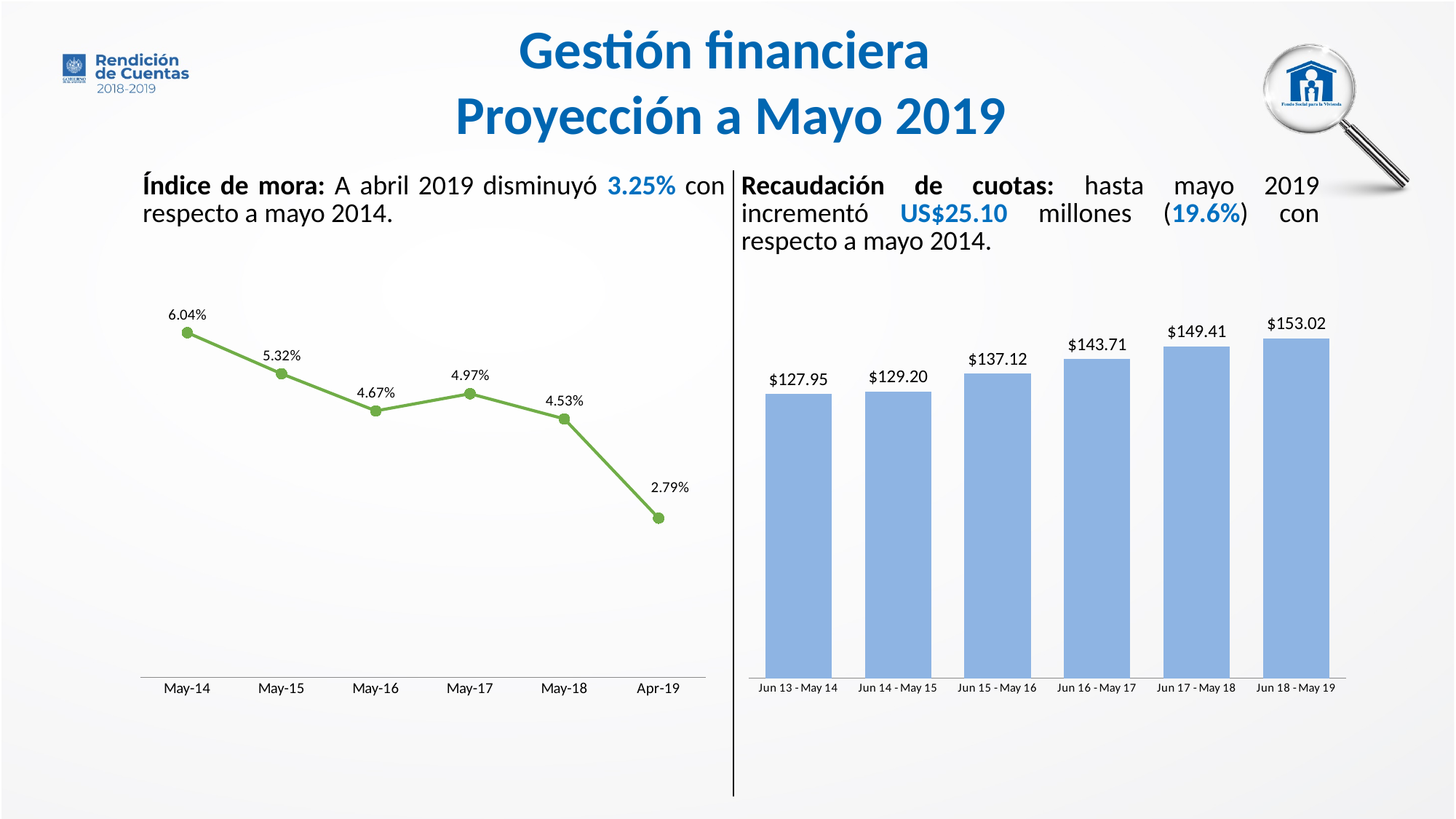
In the bar chart on the right (Recaudación de cuotas), what is the value for Jun 15 - May 16? $137.12 In the line chart on the left (Índice de mora), what is the value for Apr-19? 2.79% In the line chart on the left (Índice de mora), which point has the lowest value? Apr-19 In the line chart on the left (Índice de mora), is the value for May-16 larger or smaller than the value for May-17? smaller What kind of chart is shown on the right side of the slide (Recaudación de cuotas)? bar chart In the bar chart on the right (Recaudación de cuotas), do the values rise or fall from left to right? rise In the bar chart on the right (Recaudación de cuotas), which category has the highest value? Jun 18 - May 19 In the line chart on the left (Índice de mora), which point has the highest value? May-14 In the line chart on the left (Índice de mora), how many data points are plotted? 6 In the line chart on the left (Índice de mora), what is the difference between the May-14 value and the Apr-19 value? 3.25% In the line chart on the left (Índice de mora), what is the value for May-14? 6.04% In the bar chart on the right (Recaudación de cuotas), what is the difference between the Jun 18 - May 19 value and the Jun 13 - May 14 value? $25.07